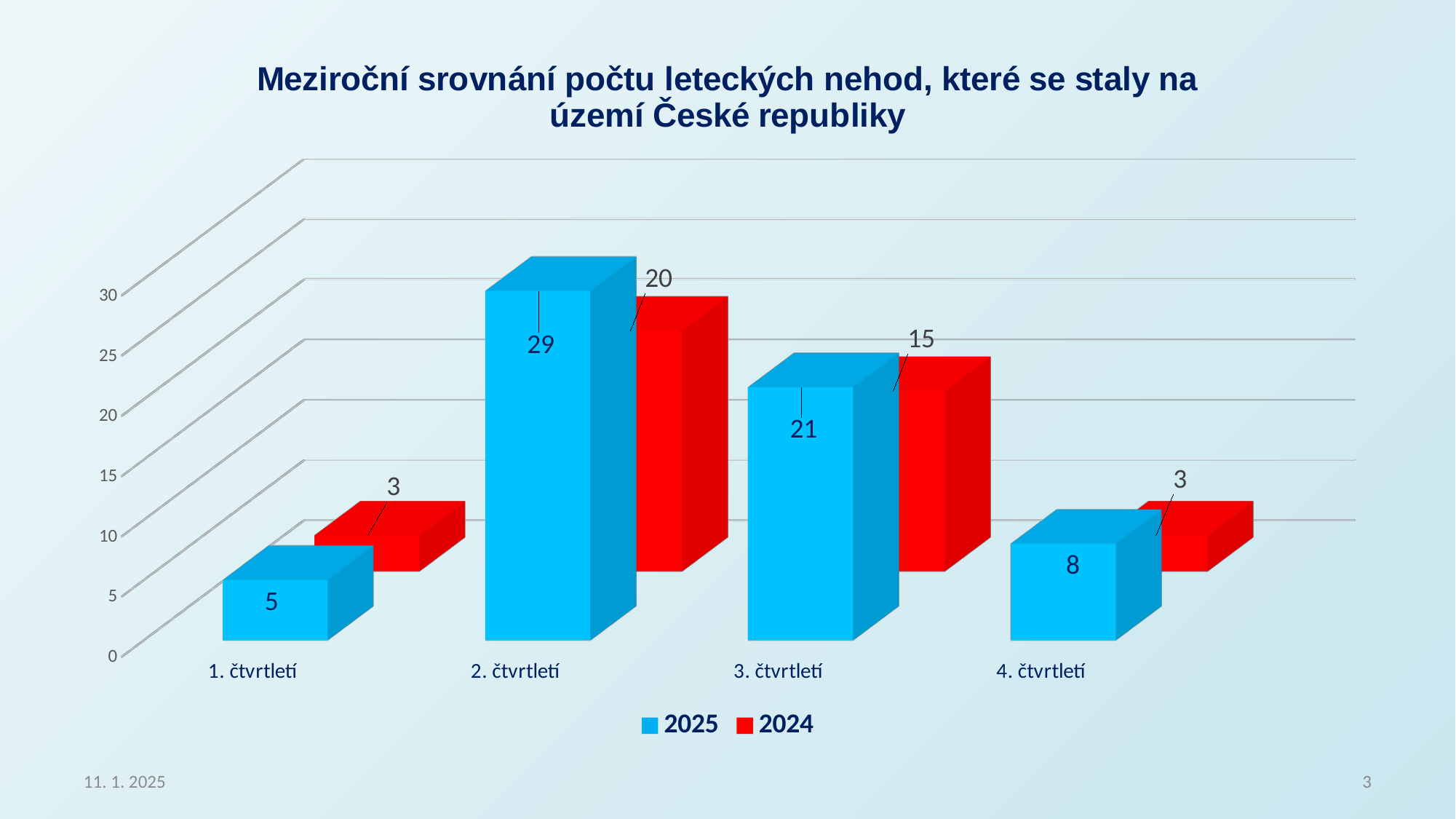
How many quarters (categories) are shown on the x axis? 4 What is the value for 2025 in 2. čtvrtletí? 29 What is the value for 2024 in 3. čtvrtletí? 15 Which is larger in 3. čtvrtletí, the 2025 value or the 2024 value? 2025 How many series does the legend list? 2 What is the value for 2024 in 1. čtvrtletí? 3 What kind of chart is shown on the slide? bar chart Which quarter has the lowest value for the 2025 series? 1. čtvrtletí Which quarter has the highest value for the 2025 series? 2. čtvrtletí What is the difference between the 2025 and 2024 values in 2. čtvrtletí? 9 Which colour represents the 2024 series in the legend? red What is the value for 2025 in 4. čtvrtletí? 8